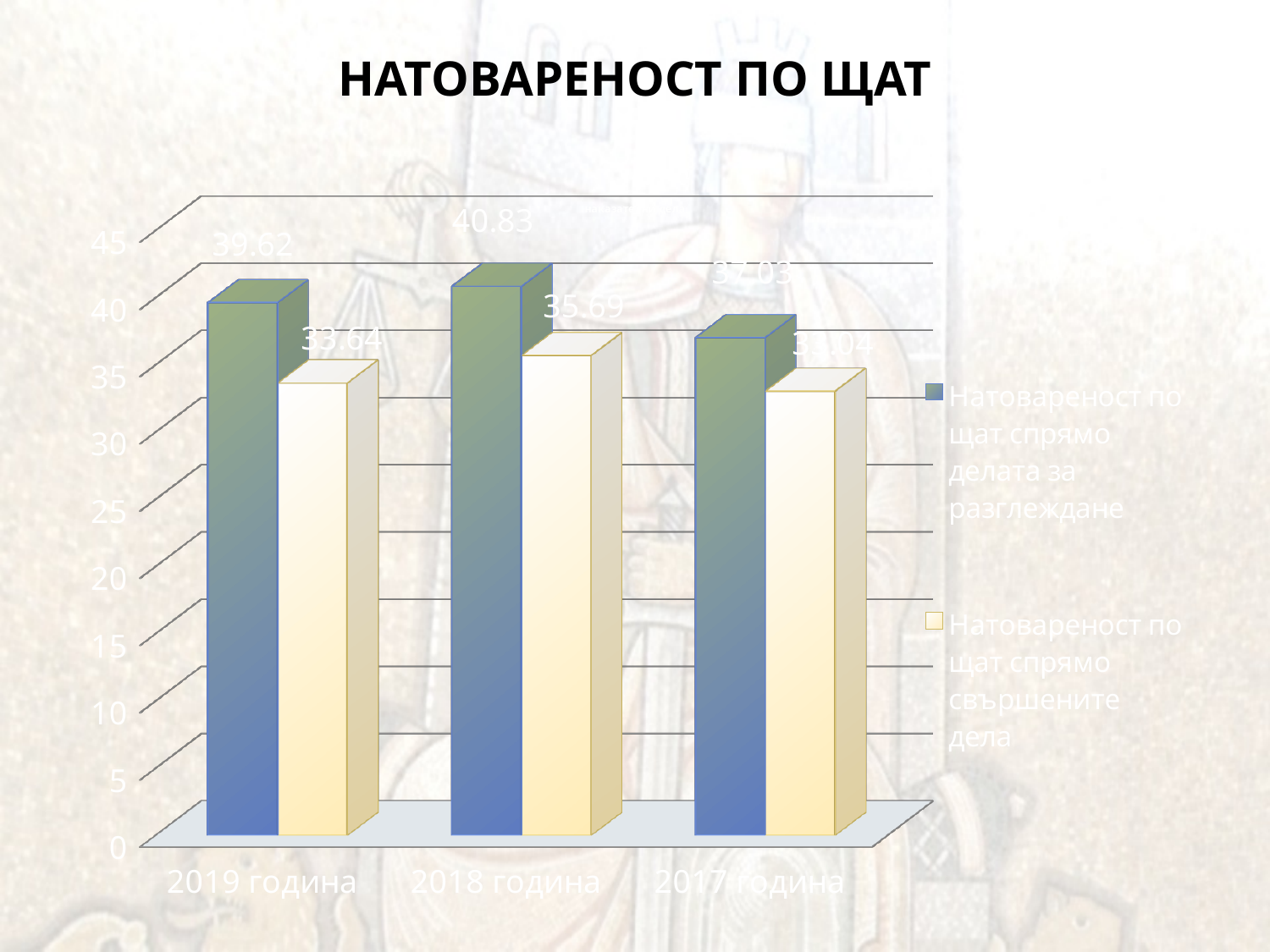
What is the value of 'Натовареност по щат спрямо делата за разглеждане' for 2018 година? 40.83 What is the difference between the two series' values for 2018 година? 5.14 What is the value of 'Натовареност по щат спрямо свършените дела' for 2018 година? 35.69 For 2019 година, which series has the larger value: 'делата за разглеждане' or 'свършените дела'? Натовареност по щат спрямо делата за разглеждане Is the value of 'Натовареност по щат спрямо свършените дела' for 2017 година greater or less than 35? less What is the title of the chart? НАТОВАРЕНОСТ ПО ЩАТ What kind of chart is shown on the slide? bar chart How many series does the legend list? 2 What is the value of 'Натовареност по щат спрямо свършените дела' for 2019 година? 33.64 Which year has the highest value for 'Натовареност по щат спрямо делата за разглеждане'? 2018 година What is the value of 'Натовареност по щат спрямо делата за разглеждане' for 2019 година? 39.62 How many year categories are shown on the x axis? 3